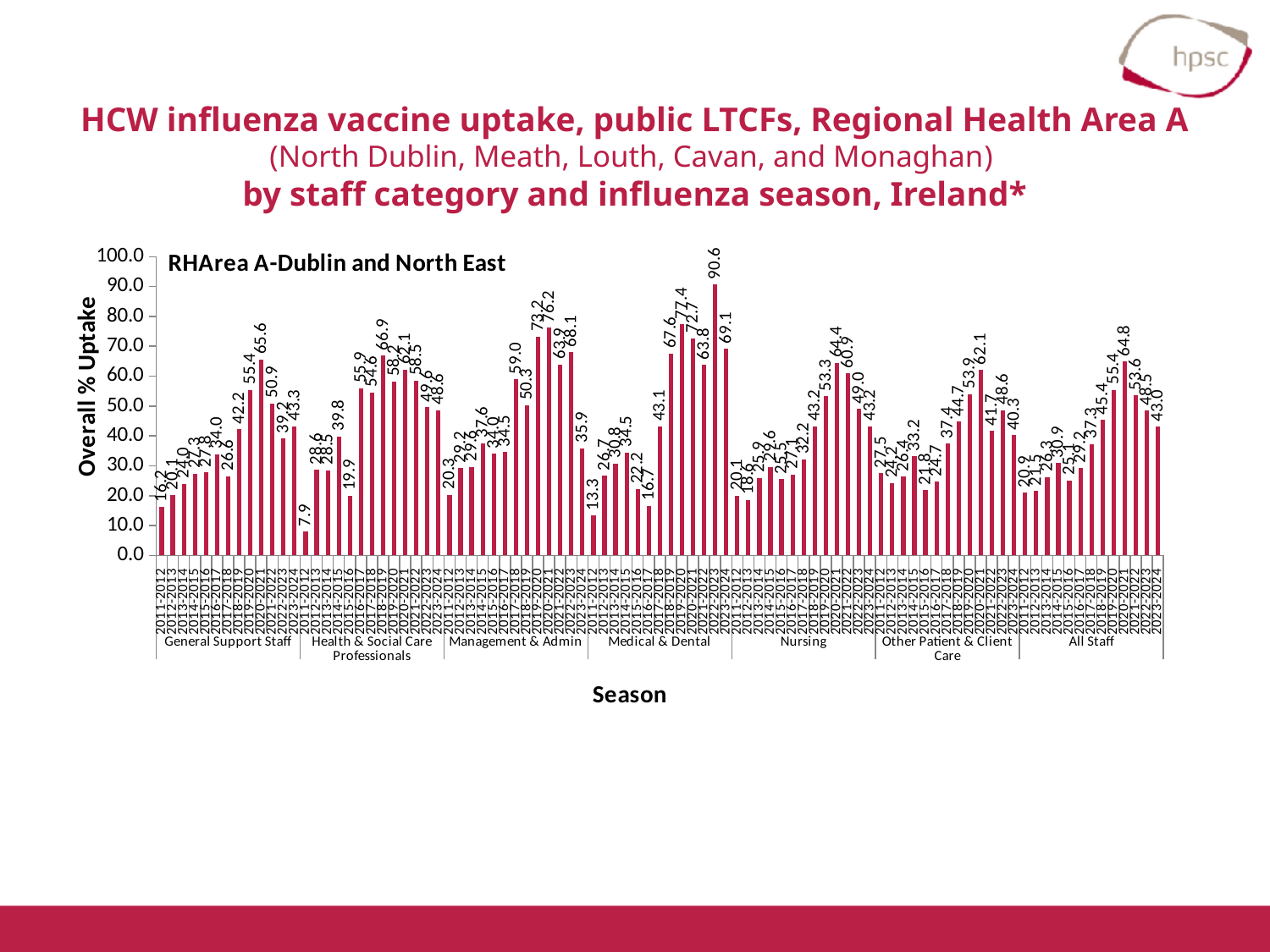
What is the overall % uptake for General Support Staff in the 2020-2021 season? 65.6 What type of chart is shown on the slide? Bar chart Which staff category and season has the highest overall % uptake on the chart? Medical & Dental, 2022-2023 (90.6) How many staff categories are shown along the x axis of the chart? 7 What is the difference in overall % uptake for Medical & Dental between the 2022-2023 season (90.6) and the 2023-2024 season (69.1)? 21.5 Is the overall % uptake for All Staff in the 2020-2021 season greater or less than 60.0? greater What is the overall % uptake for Management & Admin in the 2020-2021 season? 76.2 Which is larger: the overall % uptake for Medical & Dental in 2022-2023 or for Management & Admin in 2020-2021? Medical & Dental in 2022-2023 Which staff category and season has the lowest overall % uptake on the chart? Health & Social Care Professionals, 2011-2012 (7.9) What is the overall % uptake for Health & Social Care Professionals in the 2018-2019 season? 66.9 What is the overall % uptake for All Staff in the 2023-2024 season? 43.0 What is the title of the y axis on the chart? Overall % Uptake